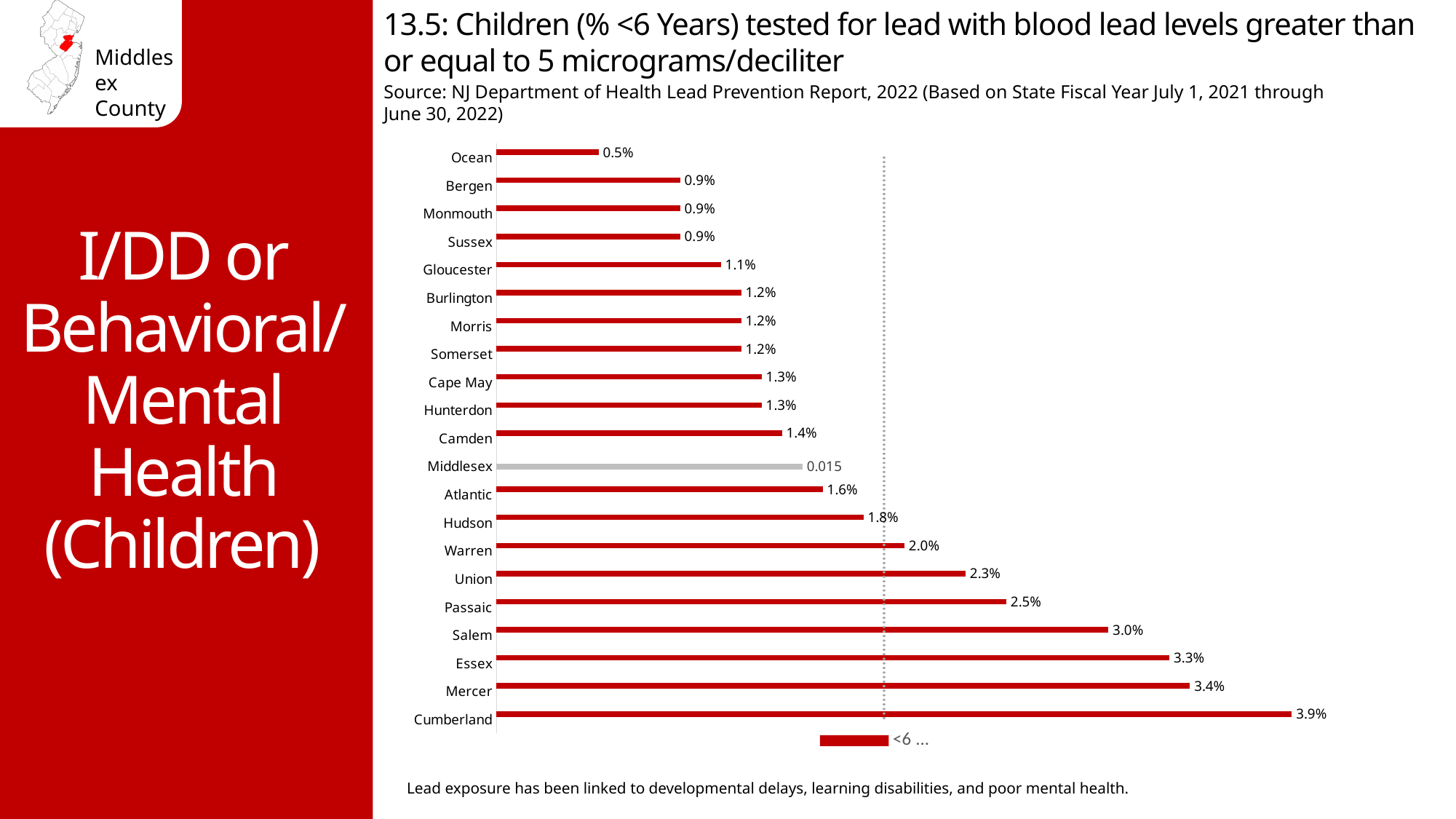
Which has a larger value, Mercer or Essex? Mercer Which county's bar is coloured grey instead of red? Middlesex How many counties are shown in the chart? 21 What is the value shown for Middlesex? 0.015 Which county has the lowest value? Ocean What is the value for Essex? 3.3% What is the value for Ocean? 0.5% What is the difference between the values for Cumberland and Ocean? 3.4% What is the difference between the values for Salem and Passaic? 0.5% What kind of chart is shown on the slide? Bar chart What is the value for Cumberland? 3.9% Which county has the highest value? Cumberland